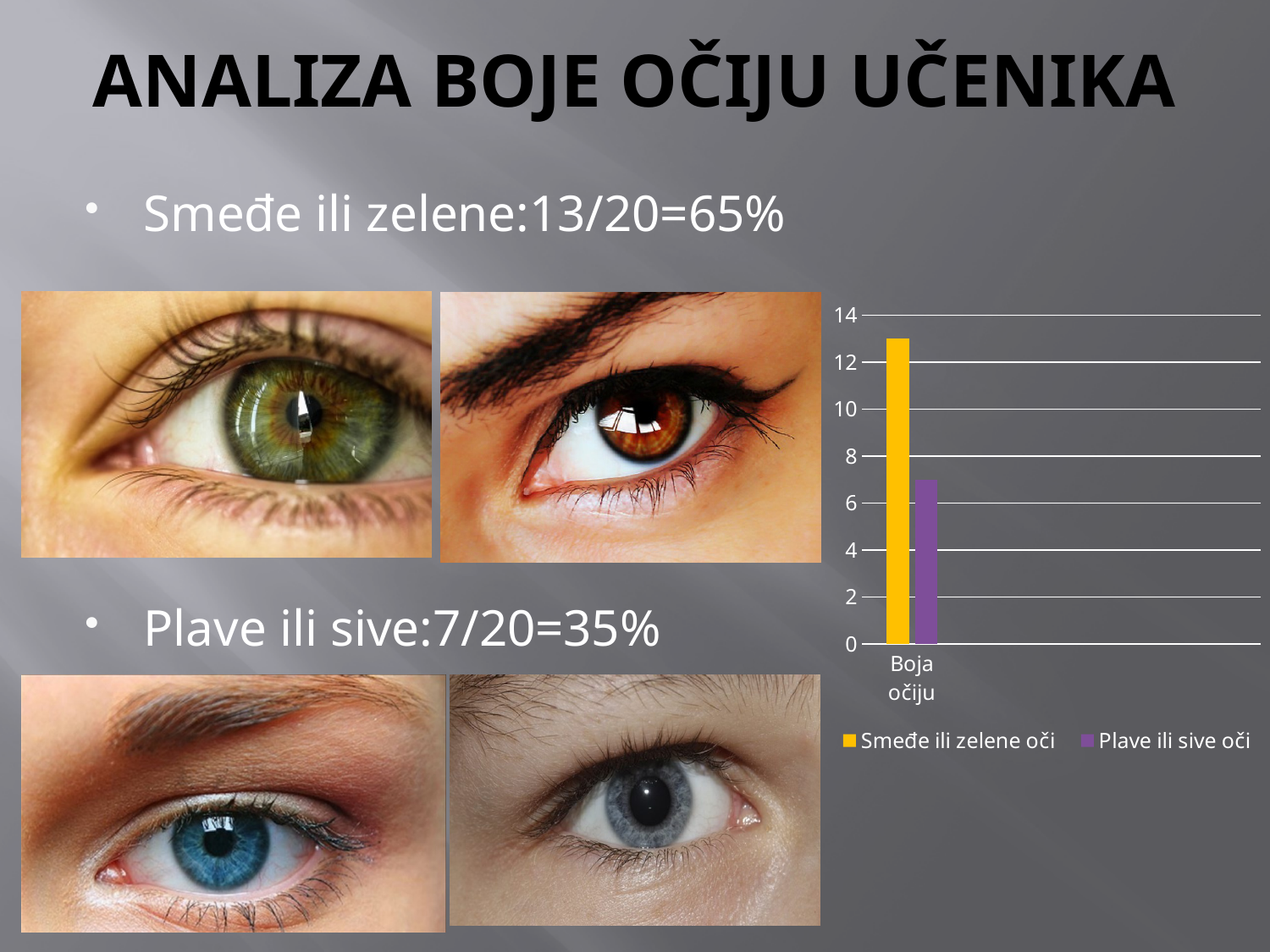
Is the value for Plave ili sive oči greater or less than 6? greater How many categories are shown on the x axis of the chart? 1 Which series has the taller bar in the chart, Smeđe ili zelene oči or Plave ili sive oči? Smeđe ili zelene oči Which series has the lowest value in the chart? Plave ili sive oči Which series is shown in yellow in the chart? Smeđe ili zelene oči What kind of chart is shown on the slide? bar chart What is the category label on the x axis of the chart? Boja očiju Is the value for Plave ili sive oči greater or less than 8? less What is the value for Smeđe ili zelene oči in the chart? 13 Is the value for Smeđe ili zelene oči greater or less than 12? greater How many series does the chart legend list? 2 What is the value for Plave ili sive oči in the chart? 7